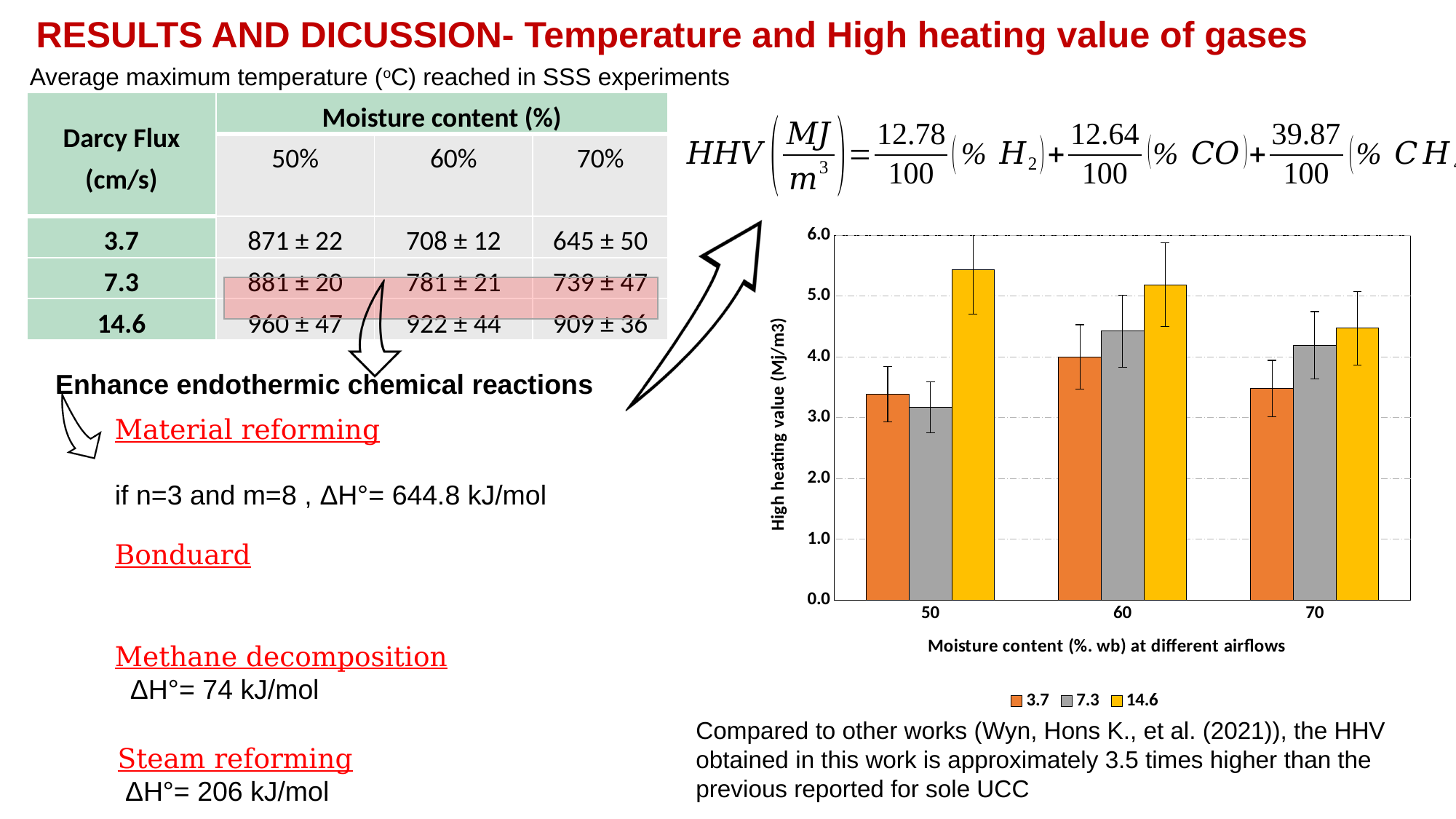
What is the y-axis title of the chart? High heating value (Mj/m3) Is the value for the 3.7 series at 70% moisture content greater or less than 4.0? less What kind of chart is shown on the slide? bar chart Is the value for the 14.6 series at 50% moisture content greater or less than 5.0? greater How many moisture content categories are shown on the x axis of the chart? 3 Do the values for the 14.6 series rise or fall as moisture content increases from 50 to 70? fall Is the value for the 7.3 series at 50% moisture content greater or less than 4.0? less Which is larger: the 14.6 series value at 50% moisture content or at 70% moisture content? 50% Which series has the highest bar at 60% moisture content? 14.6 Which series has the highest bar at 50% moisture content? 14.6 How many series does the chart's legend list? 3